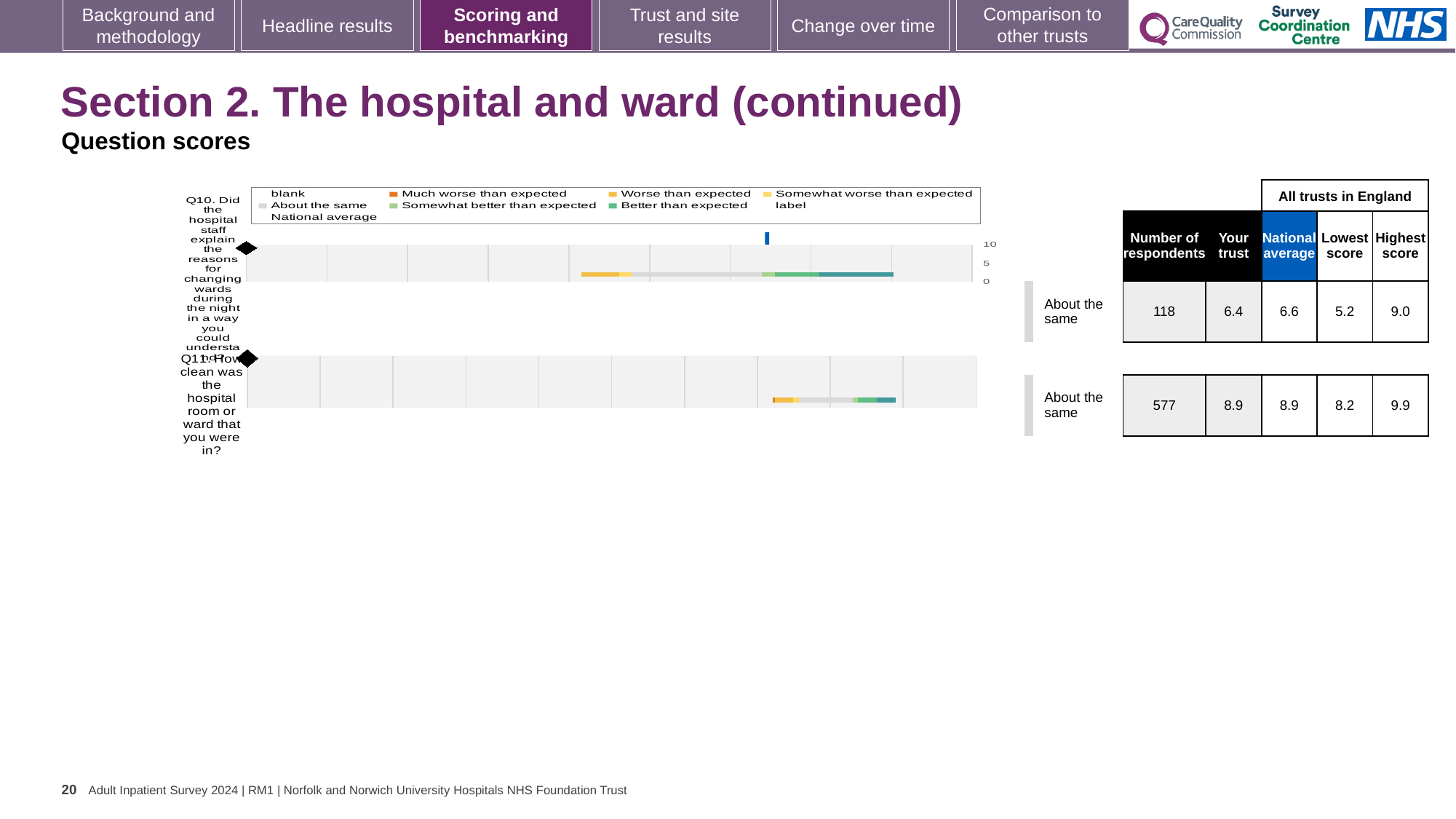
What is the 'Your trust' score for Q11 (how clean was the hospital room or ward)? 8.9 What benchmark category is shown for Q10? About the same For Q10 (explaining reasons for changing wards during the night), how many respondents are shown? 118 How many survey questions are plotted on the slide? 2 What is the 'Your trust' score for Q10? 6.4 What kind of chart is used to show the question scores for Q10 and Q11? Bar chart What is the difference between the highest and lowest scores for Q11? 1.7 What is the national average score for Q10? 6.6 What is the lowest score among all trusts in England for Q11? 8.2 What is the difference between the highest and lowest scores for Q10? 3.8 For Q10, which is larger: the 'Your trust' score or the national average? National average What is the highest score among all trusts in England for Q11? 9.9